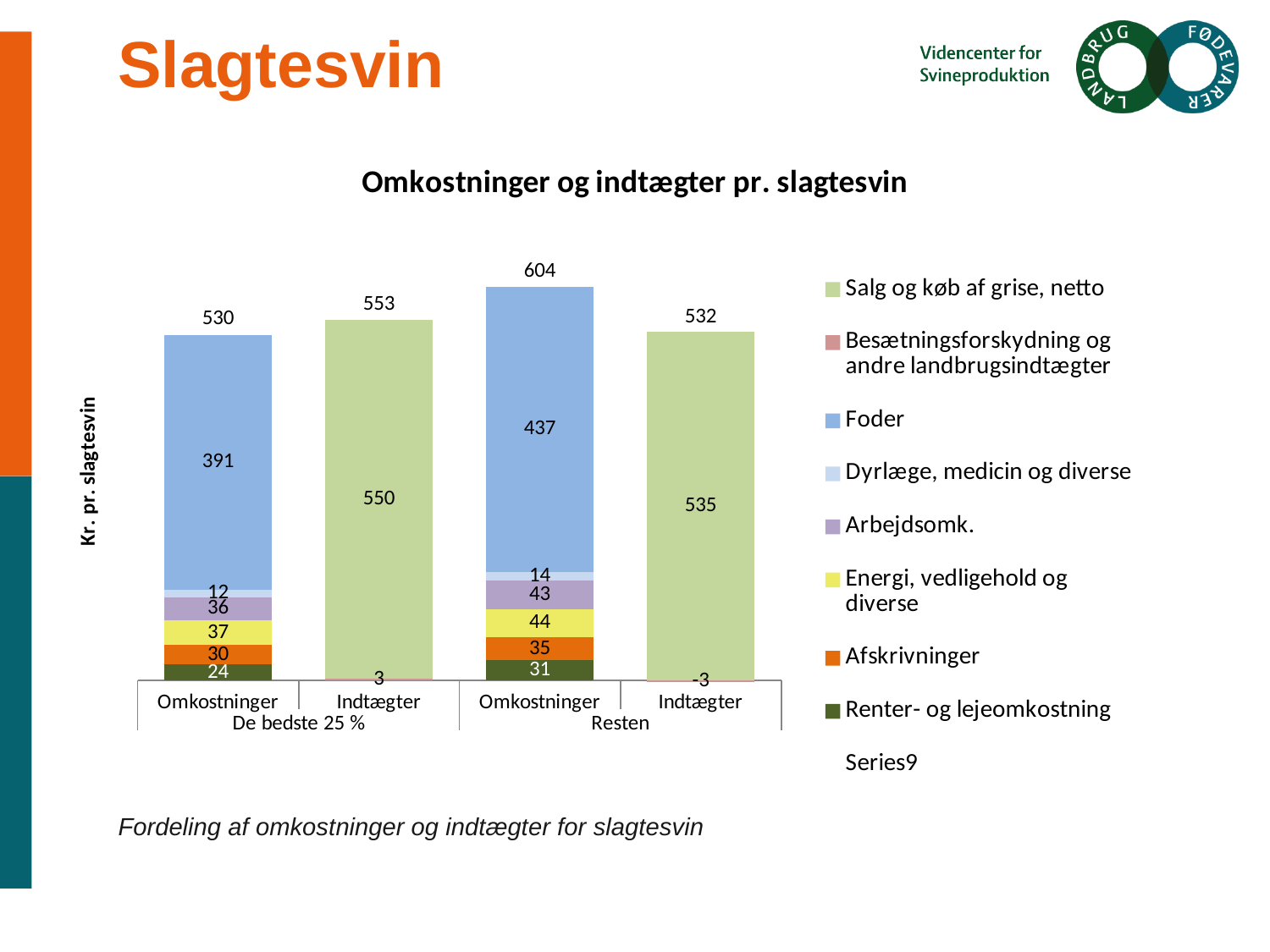
What is the Arbejdsomk. value in the Omkostninger bar for Resten? 43 What is the difference between the total Indtægter for De bedste 25 % and for Resten? 21 What is the Salg og køb af grise, netto value in the Indtægter bar for De bedste 25 %? 550 Which of the four bars has the highest total? Omkostninger for Resten (604) What is the difference between the Foder value for Resten and the Foder value for De bedste 25 %? 46 What is the Foder value in the Omkostninger bar for Resten? 437 Is the Afskrivninger value larger for De bedste 25 % or for Resten? Resten What is the total cost (Omkostninger) per slagtesvin for De bedste 25 %? 530 What type of chart is shown on the slide? Stacked bar chart Which of the four bars has the lowest total? Omkostninger for De bedste 25 % (530) How many entries does the legend list? 9 How many bars are plotted in the chart? 4